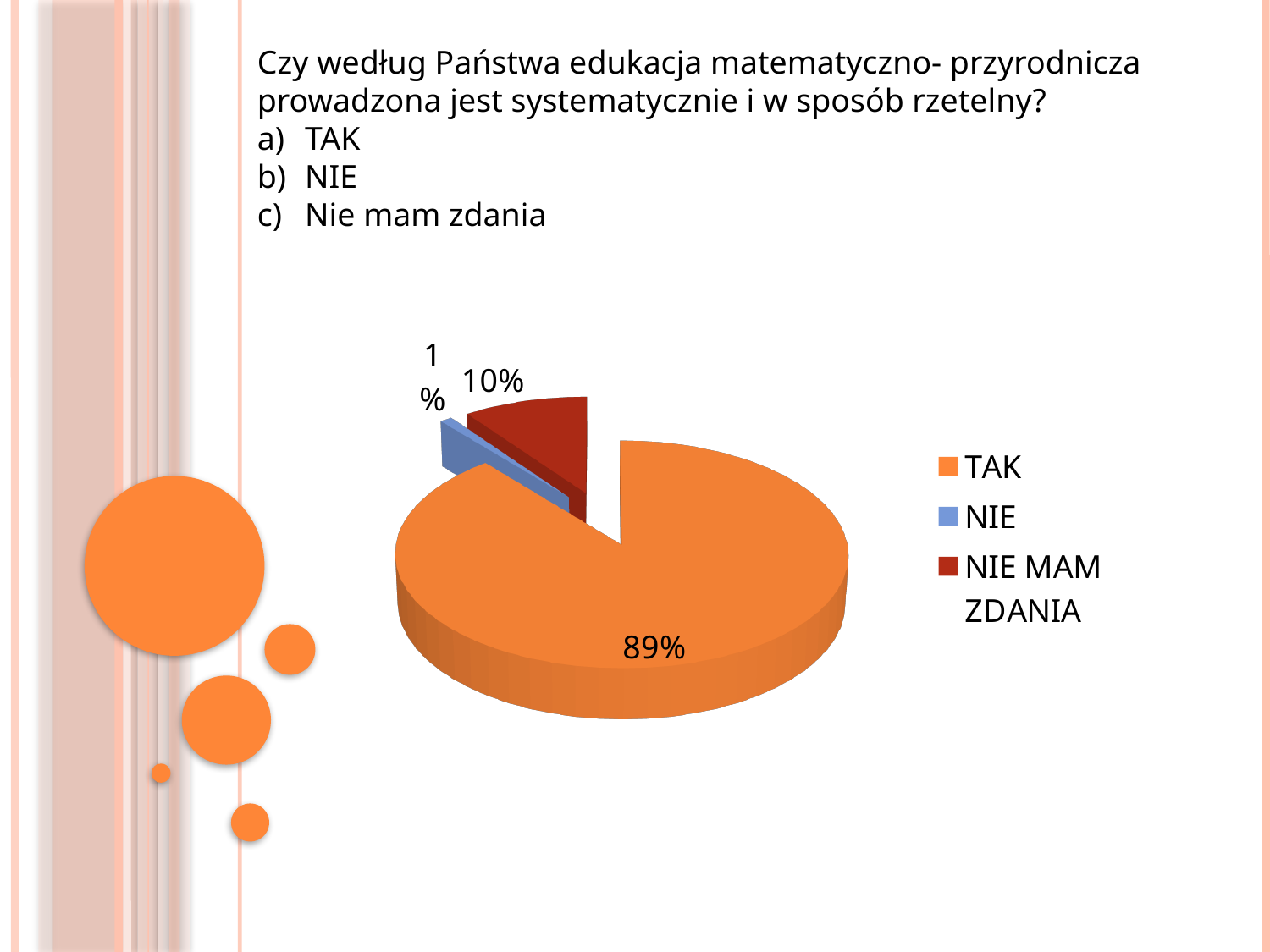
How many entries does the legend list? 3 Which category has the largest share of the pie? TAK What is the difference in percentage points between the TAK slice and the NIE MAM ZDANIA slice? 79 Which is larger, the NIE slice or the NIE MAM ZDANIA slice? NIE MAM ZDANIA What percentage of the pie is the NIE slice? 1% What kind of chart is shown on the slide? pie chart Which category has the smallest share of the pie? NIE What colour is the NIE MAM ZDANIA slice in the pie chart? dark red What percentage of the pie is the NIE MAM ZDANIA slice? 10% What colour is the TAK slice in the pie chart? orange How many slices does the pie chart have? 3 What percentage of the pie is the TAK slice? 89%